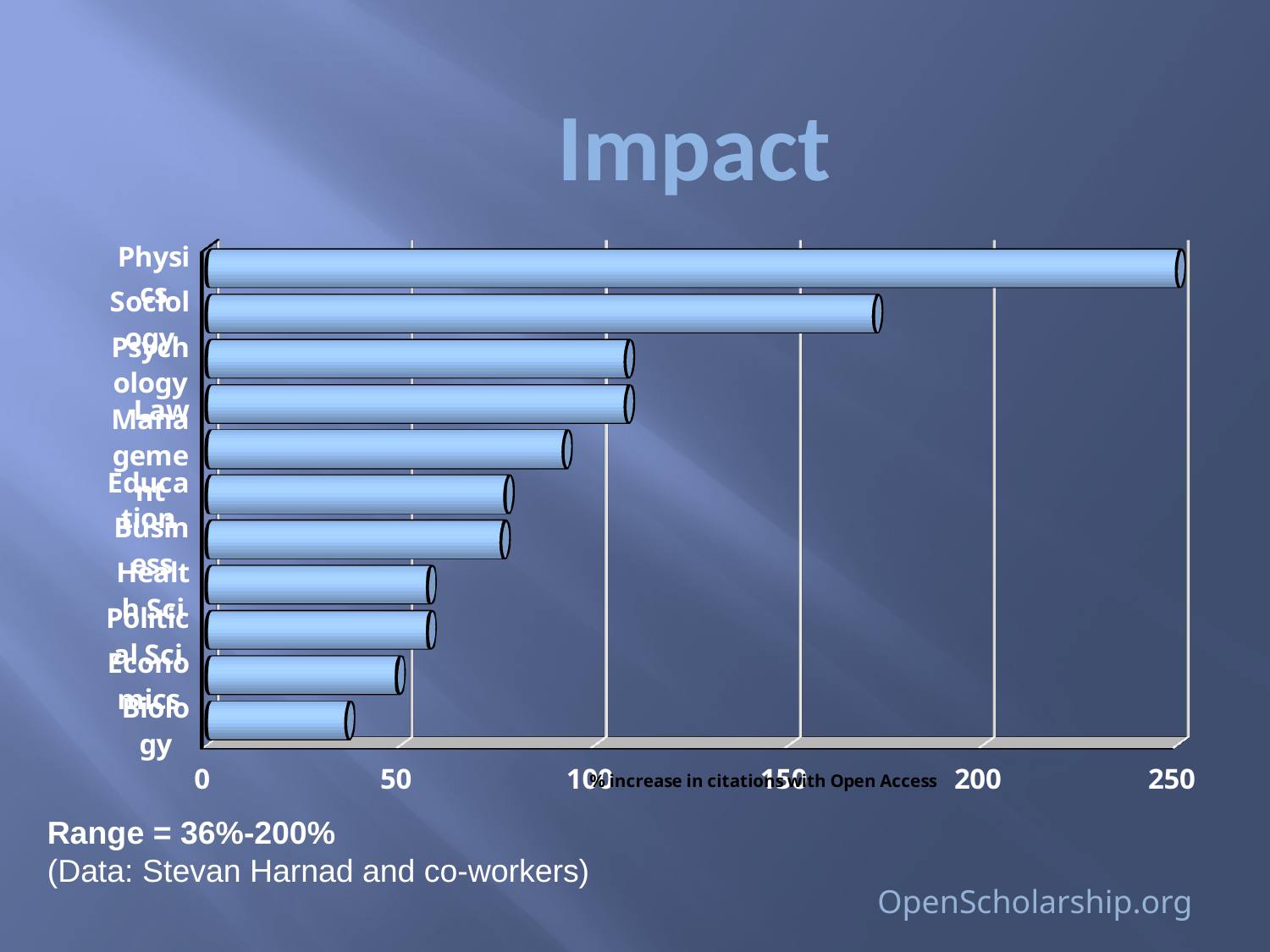
Is the value for Education greater or less than 50? greater What kind of chart is shown on the slide? bar chart What is the title of the horizontal axis of the chart? % increase in citations with Open Access Is the value for Biology greater or less than 50? less Is the value for Management greater or less than 100? less Which discipline has the highest % increase in citations with Open Access? Physics How many categories (disciplines) are plotted in the chart? 11 Which has the larger % increase in citations, Management or Education? Management Which discipline has the lowest % increase in citations with Open Access? Biology Which has the larger % increase in citations, Sociology or Law? Sociology